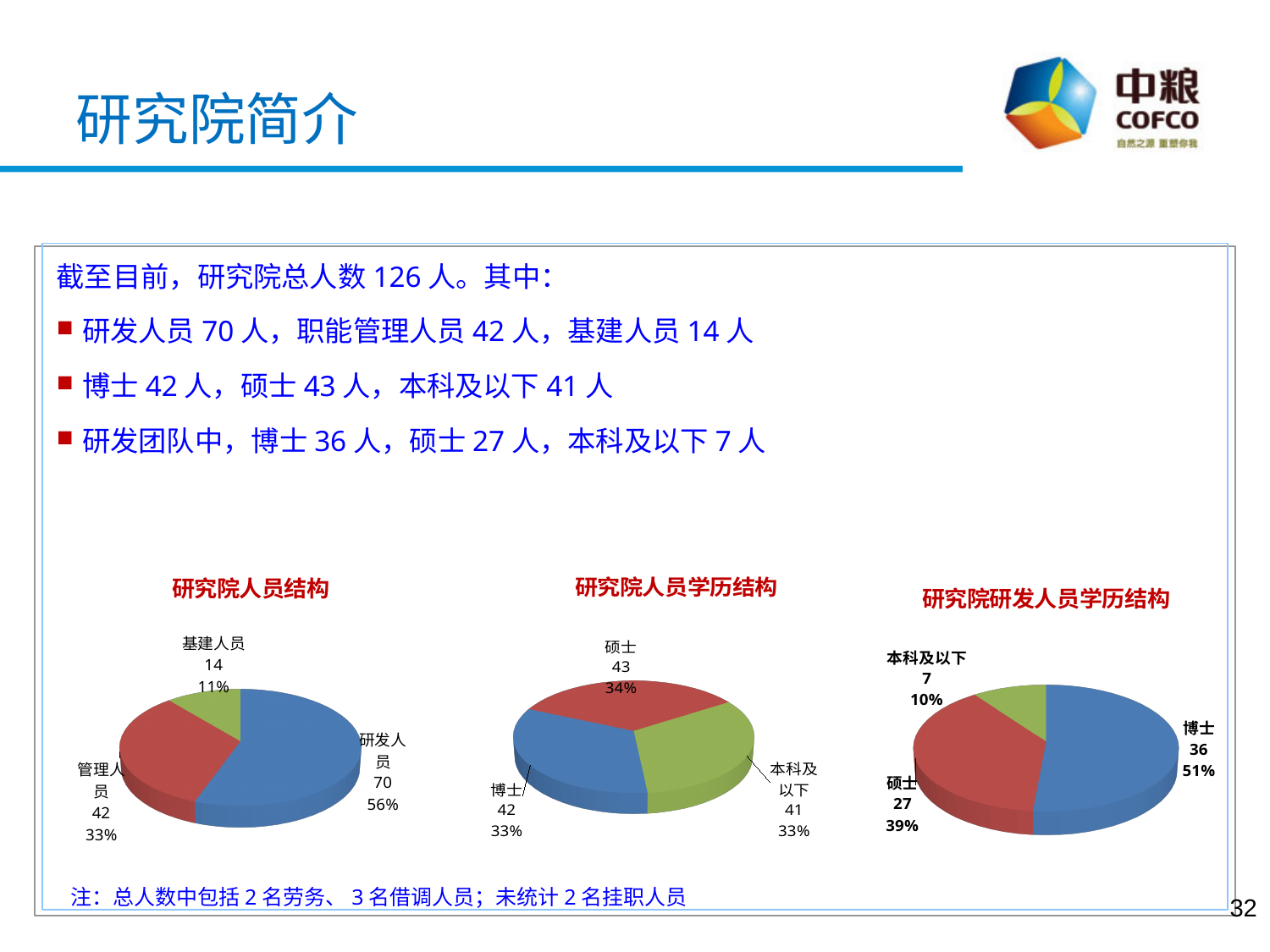
In the chart titled 研究院研发人员学历结构, which category is the largest? 博士 In the chart titled 研究院研发人员学历结构, which is larger, 硕士 or 本科及以下? 硕士 In the chart titled 研究院研发人员学历结构, what is the value for 博士? 36 In the chart titled 研究院人员学历结构, what share of the pie does 本科及以下 represent? 33% In the chart titled 研究院人员学历结构, what is the value for 硕士? 43 In the chart titled 研究院人员结构, what is the value for 研发人员? 70 In the chart titled 研究院人员结构, what share of the pie does 管理人员 represent? 33% In the chart titled 研究院研发人员学历结构, what share of the pie does 本科及以下 represent? 10% What kind of chart is the chart titled 研究院人员结构? Pie chart In the chart titled 研究院人员结构, what is the difference between the values for 研发人员 and 管理人员? 28 In the chart titled 研究院人员结构, which category is the smallest? 基建人员 How many categories does the chart titled 研究院人员学历结构 have? 3